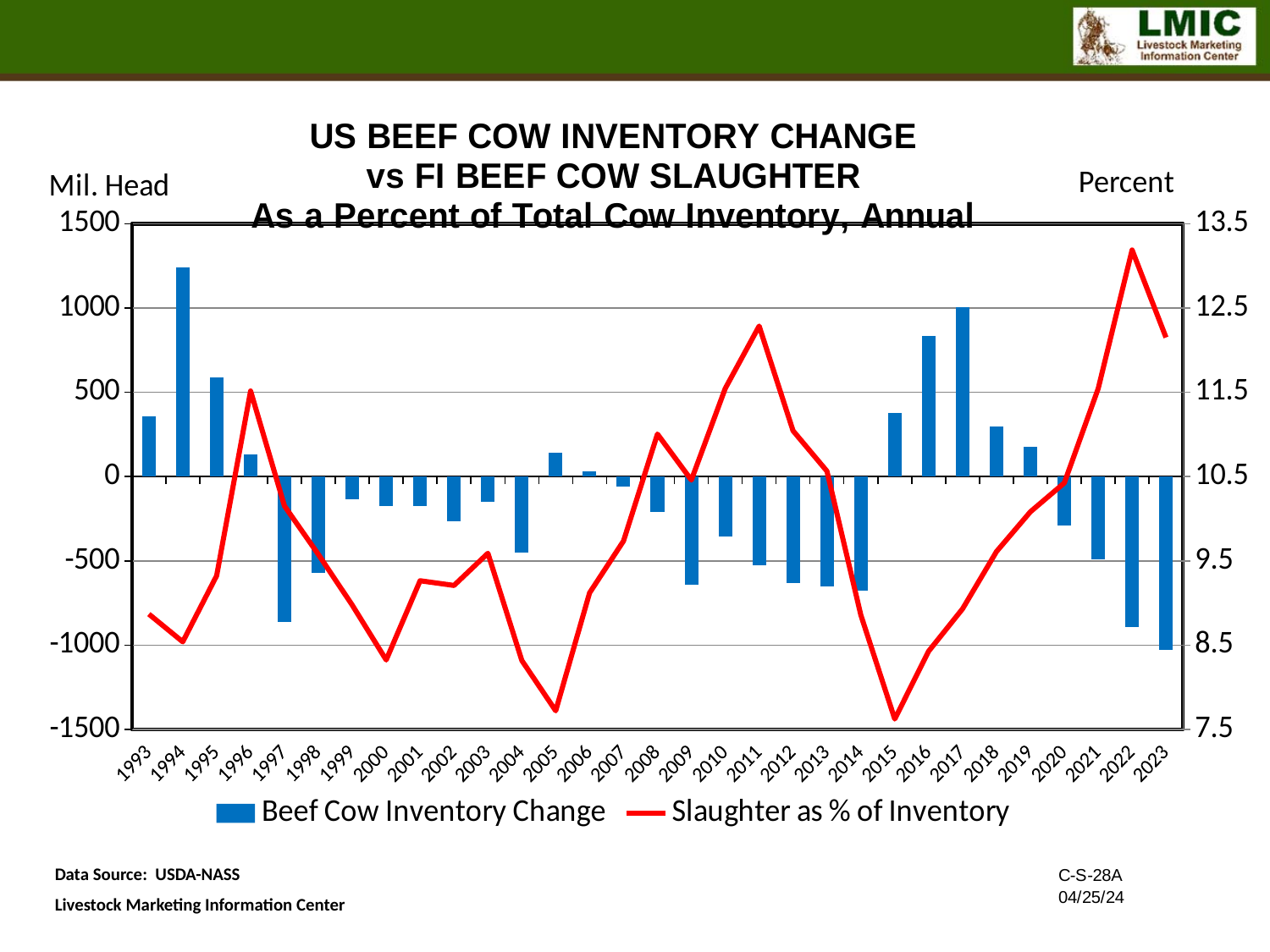
How many years are plotted along the x axis? 31 In which year is the Beef Cow Inventory Change bar the lowest? 2023 Which year has the larger Beef Cow Inventory Change bar, 1994 or 1995? 1994 In which year is the Beef Cow Inventory Change bar the highest? 1994 What kind of chart is shown on the slide? A combination bar and line chart Is the Beef Cow Inventory Change value for 1994 greater or less than 1000? greater What is the label on the left vertical axis? Mil. Head Does the Slaughter as % of Inventory line rise or fall from 2015 to 2022? rise In which year does the Slaughter as % of Inventory line reach its highest point? 2022 Is the Slaughter as % of Inventory value for 2015 greater or less than 8.5? less In which year does the Slaughter as % of Inventory line reach its lowest point? 2015 How many series does the legend list? 2